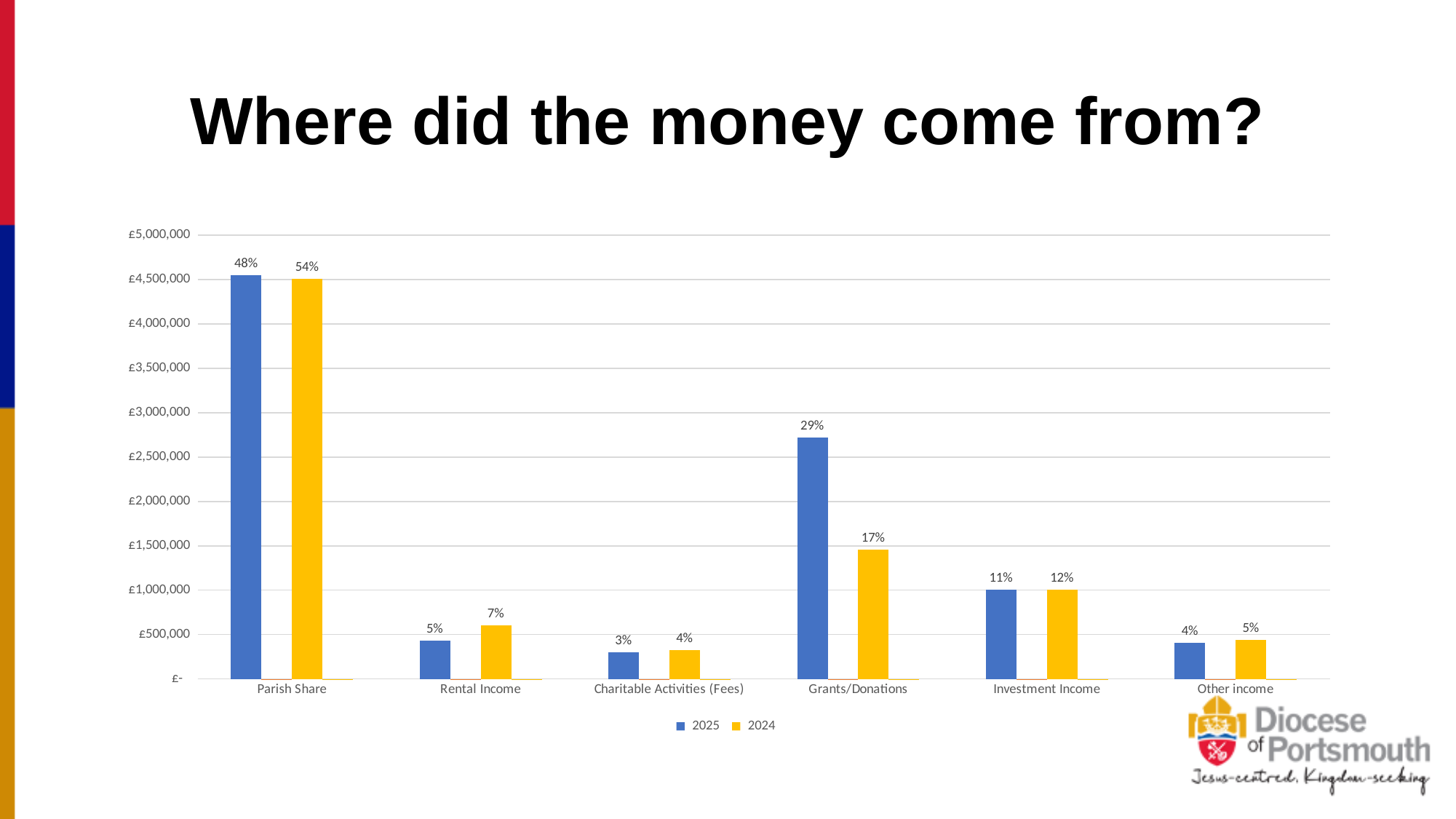
Which category has the lowest 2025 bar? Charitable Activities (Fees) Is the 2025 value for Charitable Activities (Fees) greater or less than £500,000? less How many series does the legend list? 2 Which category has the highest 2025 bar? Parish Share What percentage label is shown on the 2025 bar for Investment Income? 11% By how many percentage points does the 2025 label for Grants/Donations exceed the 2024 label? 12 Is the 2025 value for Grants/Donations greater or less than £2,500,000? greater What percentage label is shown on the 2024 bar for Grants/Donations? 17% For Grants/Donations, which year's bar is taller, 2025 or 2024? 2025 What percentage label is shown on the 2024 bar for Rental Income? 7% What percentage label is shown on the 2025 bar for Parish Share? 48% How many income categories are shown on the x axis? 6